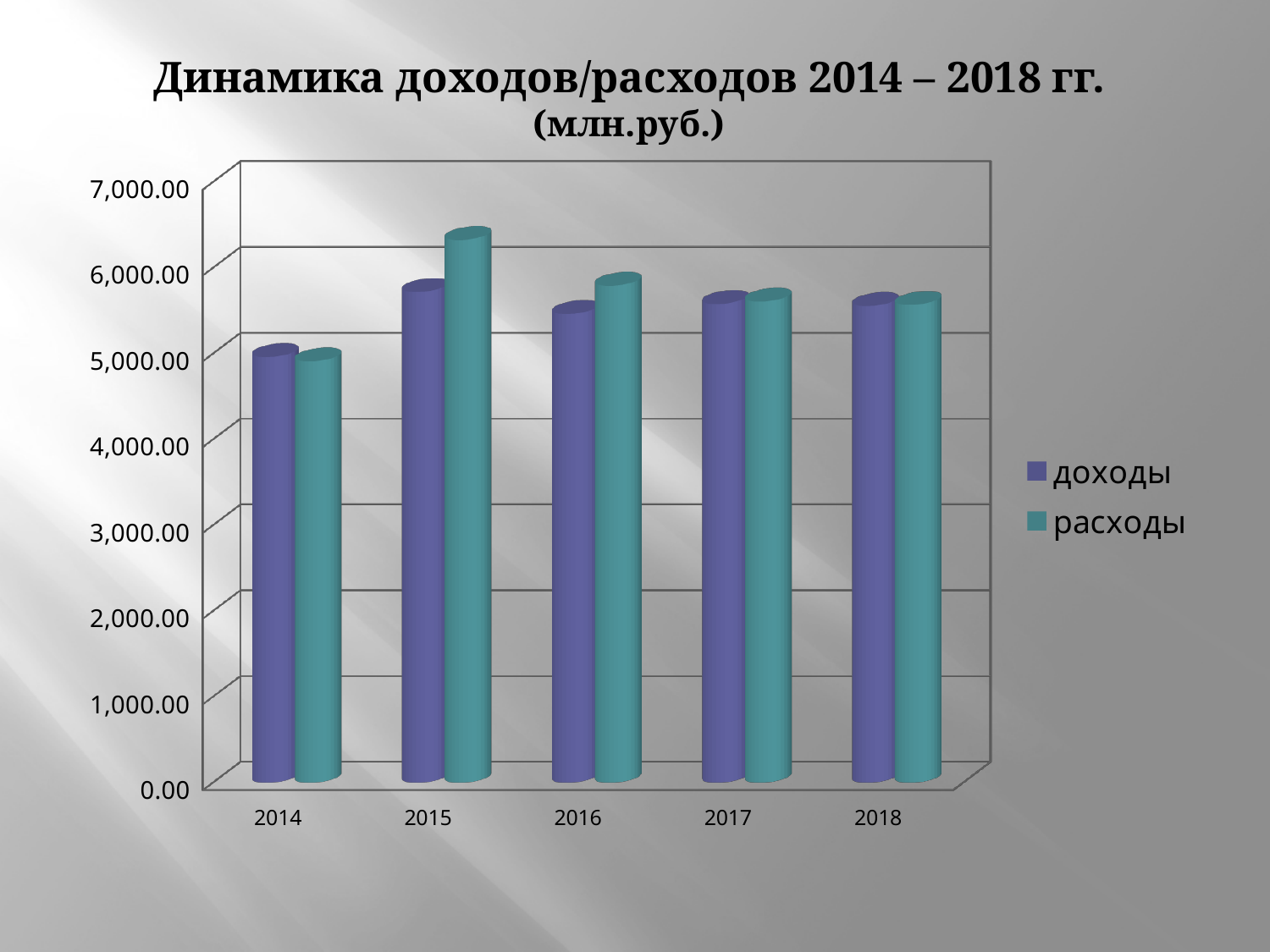
Does the value for доходы rise or fall from 2014 to 2015? rise In which year is the value for расходы the highest? 2015 In which year is the value for доходы the lowest? 2014 How many years are shown on the x axis of the chart? 5 How many series does the legend list? 2 Is the value for доходы in 2014 greater or less than 6,000.00? less What is the title of the chart? Динамика доходов/расходов 2014 – 2018 гг. (млн.руб.) In 2015, which is larger: доходы or расходы? расходы Which series are listed in the legend? доходы, расходы Is the value for расходы in 2015 greater or less than 6,000.00? greater What kind of chart is shown on the slide? bar chart In which year is the value for расходы the lowest? 2014